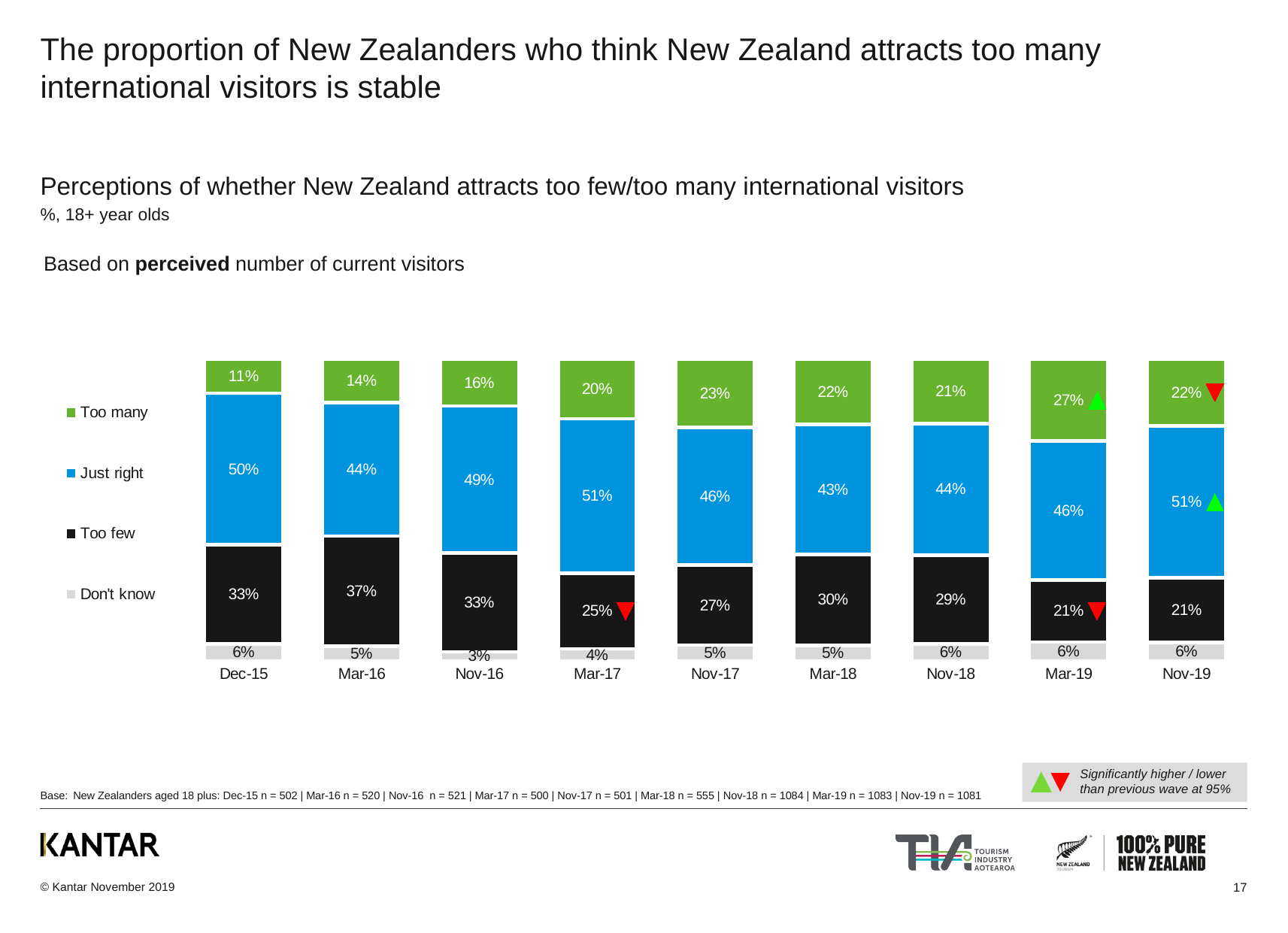
In which wave is the "Don't know" share lowest? Nov-16 How many series does the legend list? 4 What percentage of respondents said "Too many" in Mar-19? 27% Does the "Too many" share rise or fall from Dec-15 to Mar-17? Rise What kind of chart is shown on the slide? Stacked bar chart What is the "Too few" value for Mar-16? 37% In which wave is the "Too many" share highest? Mar-19 In which wave is the "Too many" share lowest? Dec-15 How many survey waves are shown on the x axis? 9 Which is larger: the "Too few" share in Dec-15 or in Mar-17? Dec-15 By how many percentage points did the "Too many" share fall from Mar-19 to Nov-19? 5 percentage points What is the "Just right" value for Nov-19? 51%